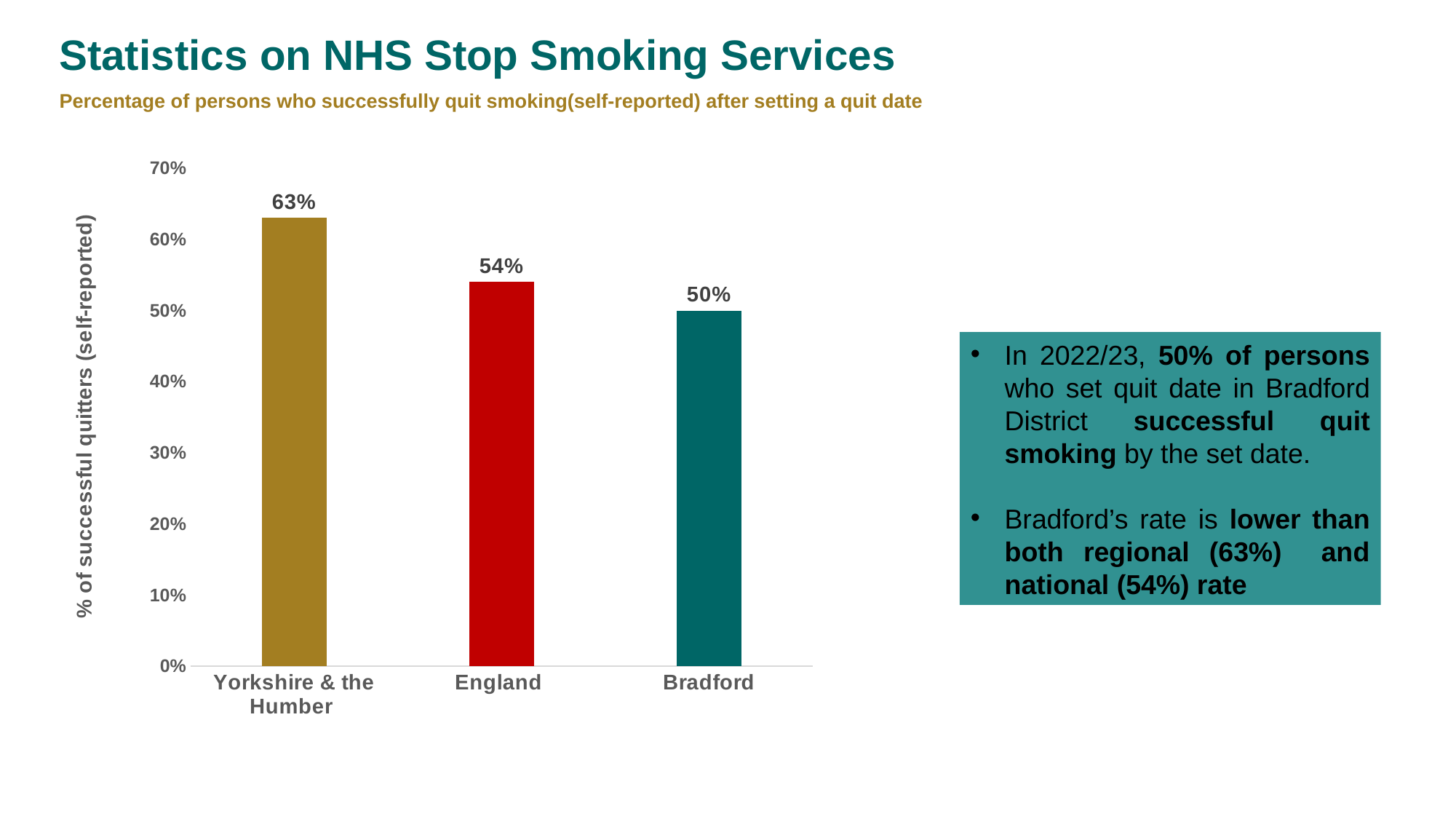
What kind of chart is shown on the slide? Bar chart What is the label of the vertical axis of the chart? % of successful quitters (self-reported) Which category has the lowest percentage of successful quitters? Bradford Is the value for Yorkshire & the Humber greater or less than 60%? greater What is the percentage of successful quitters for Yorkshire & the Humber? 63% What is the percentage of successful quitters for England? 54% What is the percentage of successful quitters for Bradford? 50% What is the difference in percentage points between England and Bradford? 4 percentage points How many categories are shown on the chart? 3 What is the difference in percentage points between Yorkshire & the Humber and Bradford? 13 percentage points Which category has the highest percentage of successful quitters? Yorkshire & the Humber Which has a higher percentage of successful quitters, England or Bradford? England